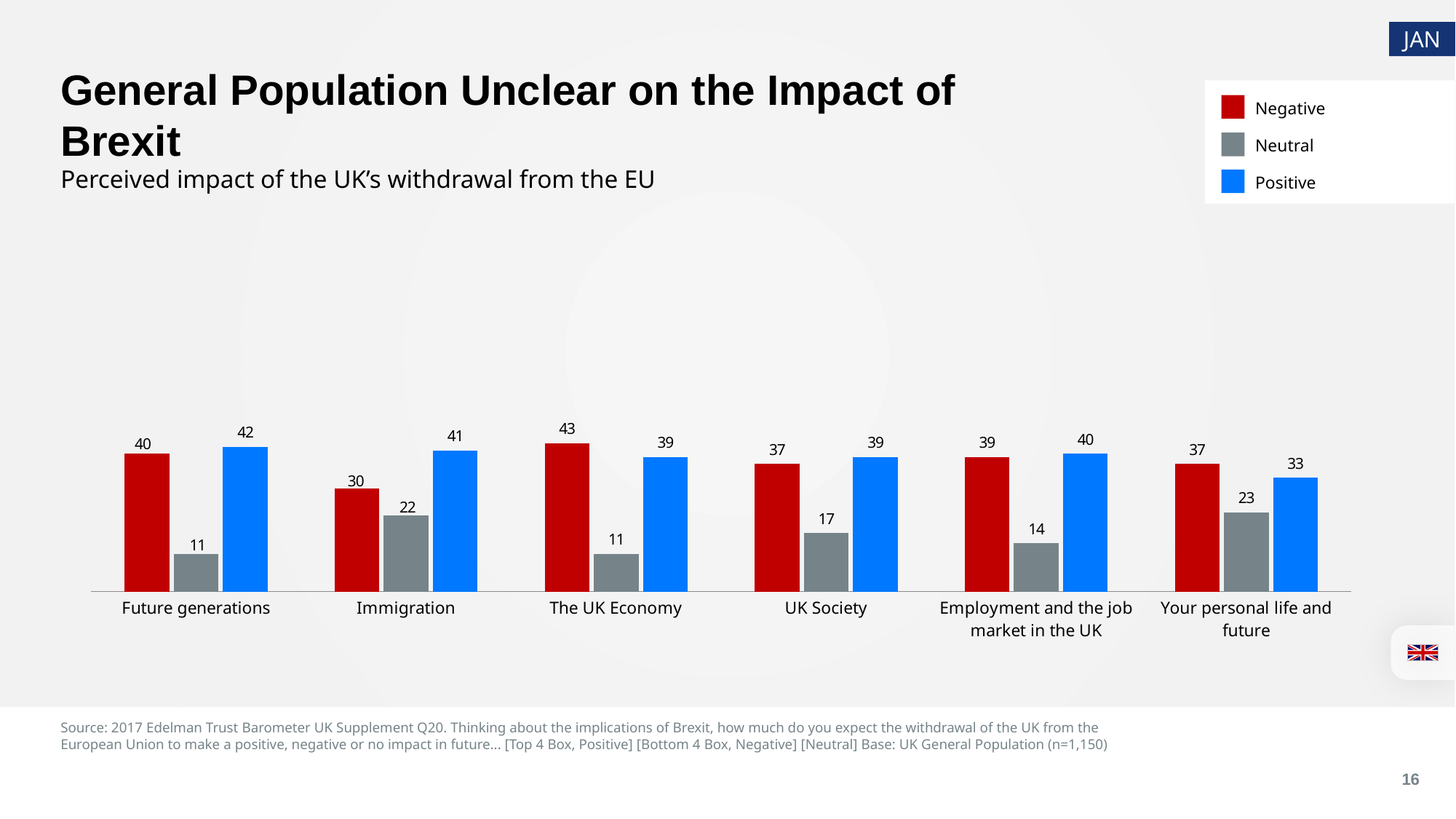
Which colour represents the Neutral series in the legend? Grey What is the difference between the Positive and Negative values for Immigration? 11 Which category has the lowest Positive value? Your personal life and future What is the Negative value for The UK Economy? 43 What is the Positive value for Your personal life and future? 33 How many categories are shown on the x axis? 6 What is the Neutral value for Immigration? 22 What kind of chart is shown on the slide? Bar chart How many series does the legend list? 3 Which is larger for UK Society: the Negative value or the Positive value? Positive Which category has the highest Negative value? The UK Economy What is the difference between the Neutral values for Immigration and The UK Economy? 11